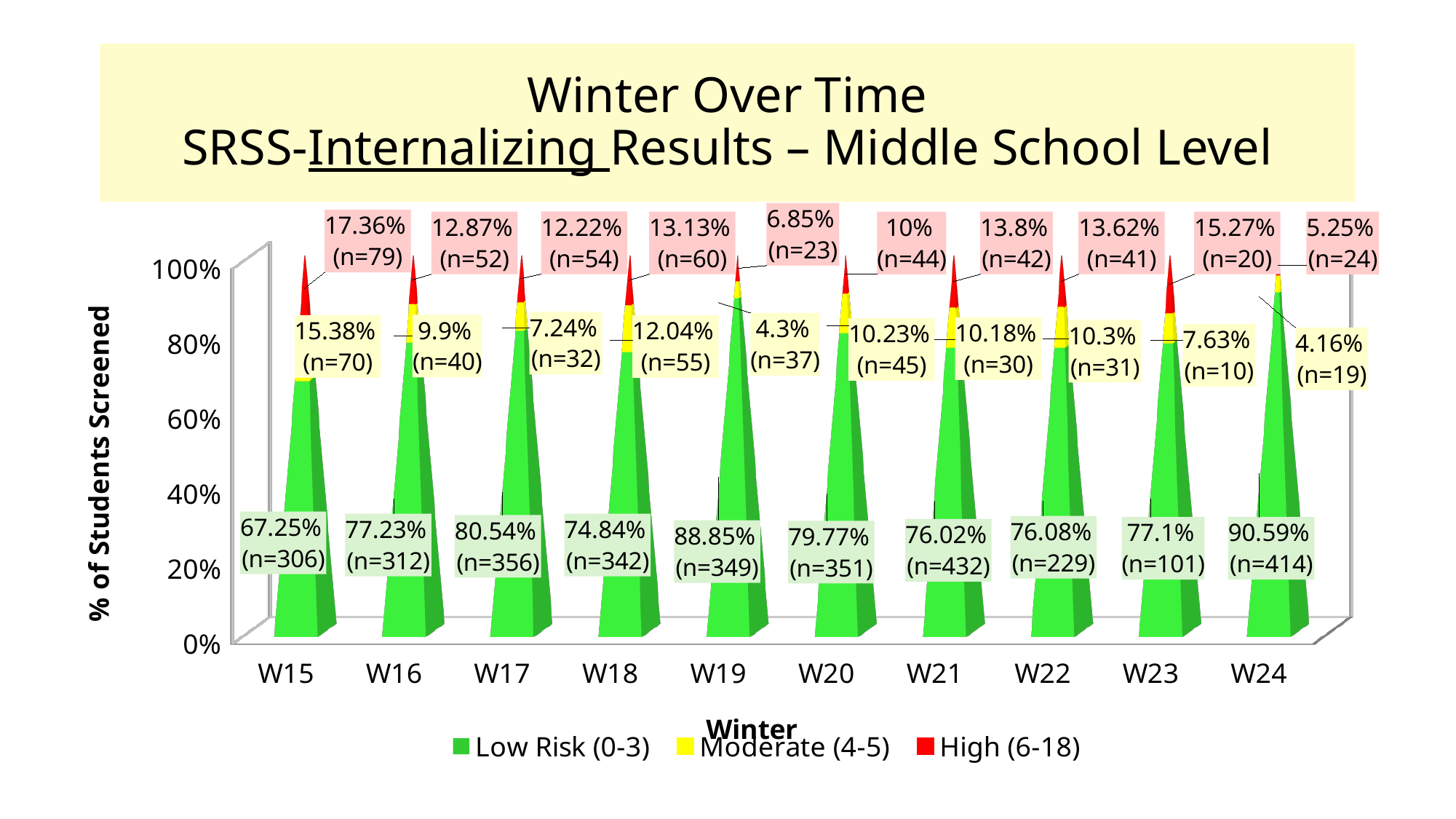
What percentage of students screened were High (6-18) in W15? 17.36% What percentage of students screened were Low Risk (0-3) in W24? 90.59% What is the difference between the Low Risk (0-3) percentage in W24 and in W15? 23.34% Which winter has the lowest High (6-18) percentage? W24 Which winter has the highest Low Risk (0-3) percentage? W24 How many winters are shown on the x axis? 10 What is the Moderate (4-5) percentage for W18? 12.04% Which is larger, the High (6-18) percentage in W19 or in W20? W20 Which winter has the lowest Low Risk (0-3) percentage? W15 What kind of chart is shown on the slide? Stacked bar chart How many series does the legend list? 3 How many students were in the Low Risk (0-3) group in W21? n=432